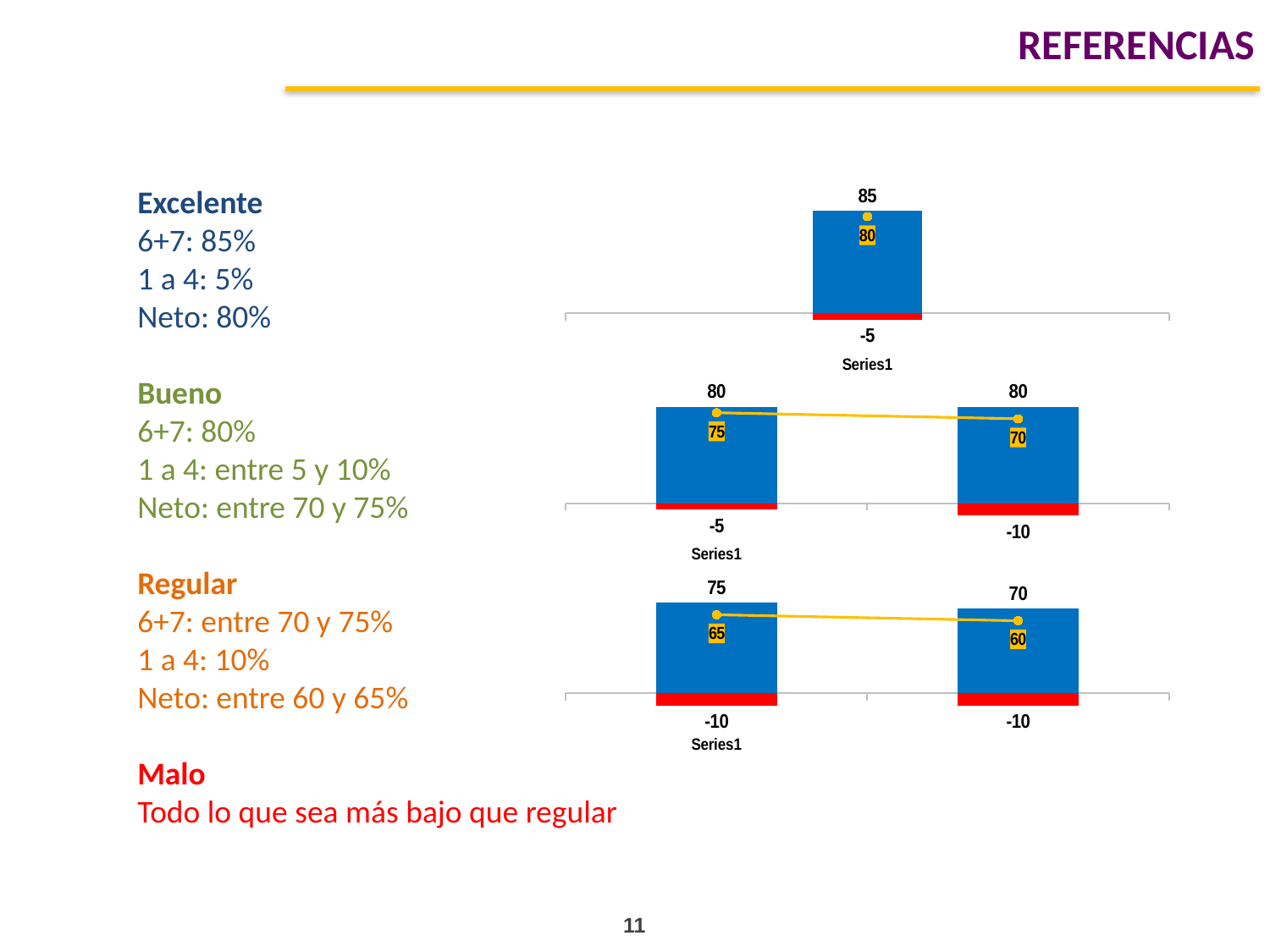
In the bottom chart, what is the difference between the two blue bar values (75 and 70)? 5 In the top chart, what value is printed below the red bar? -5 What kind of chart is the middle chart? bar chart with a line overlay How many bars are plotted in the middle chart? 4 In the top chart, what value is labelled on the yellow line marker? 80 How many charts are shown on the slide? 3 In the bottom chart, what is the lowest value labelled on the yellow line? 60 In the top chart, what is the value printed above the blue bar? 85 In the middle chart, what is the value printed below the right-hand red bar? -10 In the middle chart, which yellow line marker has the larger value, the left one (75) or the right one (70)? the left one What label appears on the x axis of each chart? Series1 In the bottom chart, what value is printed below the left-hand red bar? -10